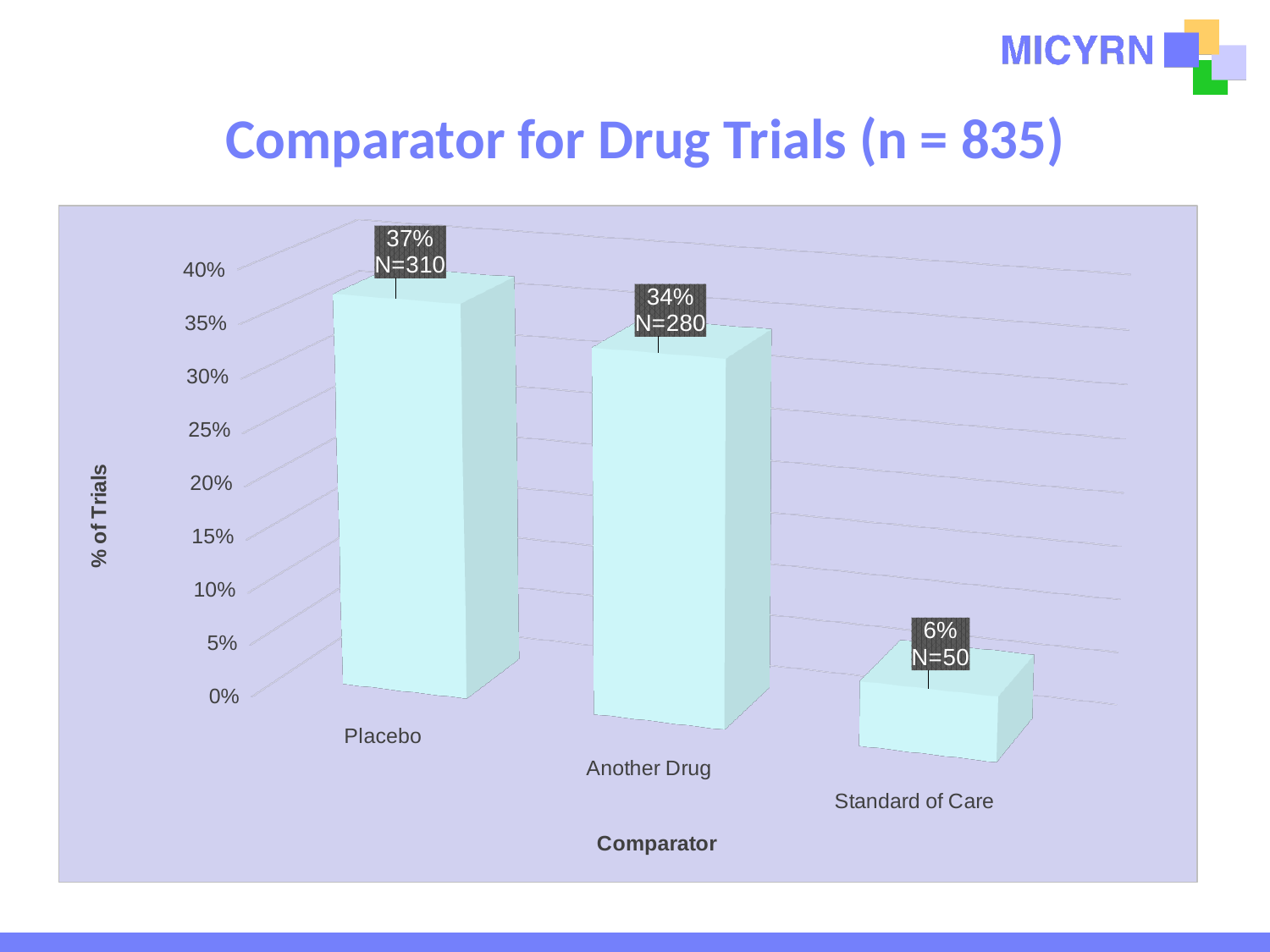
Which has a larger percentage of trials, Another Drug or Standard of Care? Another Drug Which comparator has the highest percentage of trials? Placebo How many trials (N) used Another Drug as the comparator? N=280 What kind of chart is shown on the slide? Bar chart What is the difference in percentage points between Placebo and Standard of Care? 31% Which comparator has the lowest percentage of trials? Standard of Care What percentage of trials used Another Drug as the comparator? 34% What percentage of trials used Standard of Care as the comparator? 6% What percentage of trials used Placebo as the comparator? 37% How many comparator categories are shown in the chart? 3 How many trials (N) used Standard of Care as the comparator? N=50 What is the title of the chart? Comparator for Drug Trials (n = 835)